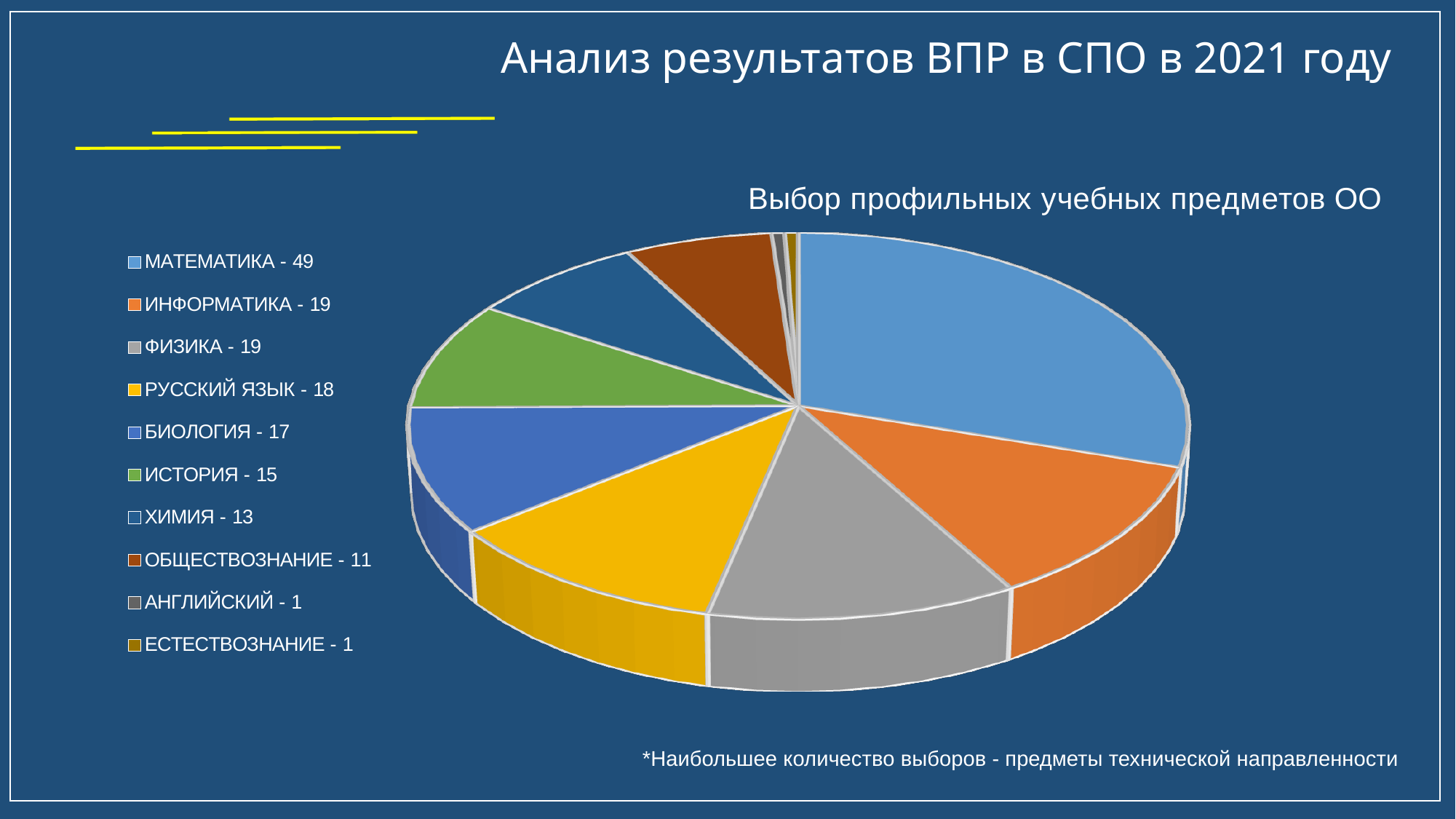
What is the value for МАТЕМАТИКА? 49 Which is larger, the value for РУССКИЙ ЯЗЫК or the value for БИОЛОГИЯ? РУССКИЙ ЯЗЫК What is the difference between the values for ИСТОРИЯ and ХИМИЯ? 2 What is the difference between the values for МАТЕМАТИКА and ИНФОРМАТИКА? 30 Which subjects have the lowest value? АНГЛИЙСКИЙ and ЕСТЕСТВОЗНАНИЕ How many categories (subjects) does the pie chart show? 10 What is the value for ОБЩЕСТВОЗНАНИЕ? 11 What is the total of all the values shown in the legend? 163 Which subject has the highest value? МАТЕМАТИКА What kind of chart is shown on the slide? Pie chart What is the value for БИОЛОГИЯ? 17 What is the title of the chart? Выбор профильных учебных предметов ОО